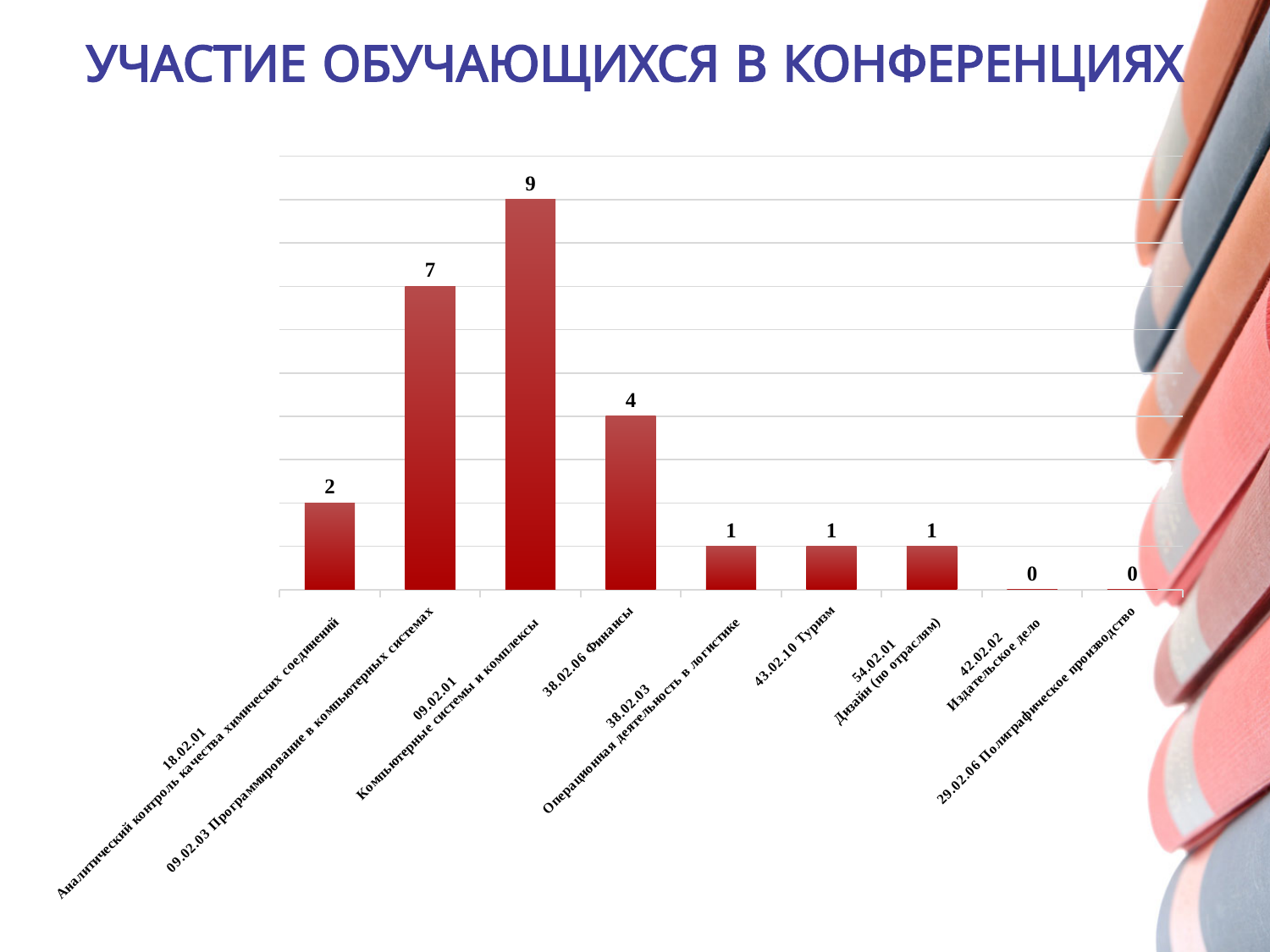
How many categories are shown on the x axis? 9 Which category has the highest value? 09.02.01 Компьютерные системы и комплексы What value is shown for 09.02.01 Компьютерные системы и комплексы? 9 What kind of chart is shown on the slide? Bar chart What value is shown for 42.02.02 Издательское дело? 0 What is the difference between the values for 09.02.01 Компьютерные системы и комплексы and 09.02.03 Программирование в компьютерных системах? 2 Which is larger, the value for 38.02.06 Финансы or the value for 18.02.01 Аналитический контроль качества химических соединений? 38.02.06 Финансы What value is shown for 18.02.01 Аналитический контроль качества химических соединений? 2 What is the difference between the values for 09.02.03 Программирование в компьютерных системах and 38.02.06 Финансы? 3 What is the title of the slide? УЧАСТИЕ ОБУЧАЮЩИХСЯ В КОНФЕРЕНЦИЯХ What value is shown for 38.02.06 Финансы? 4 What value is shown for 43.02.10 Туризм? 1